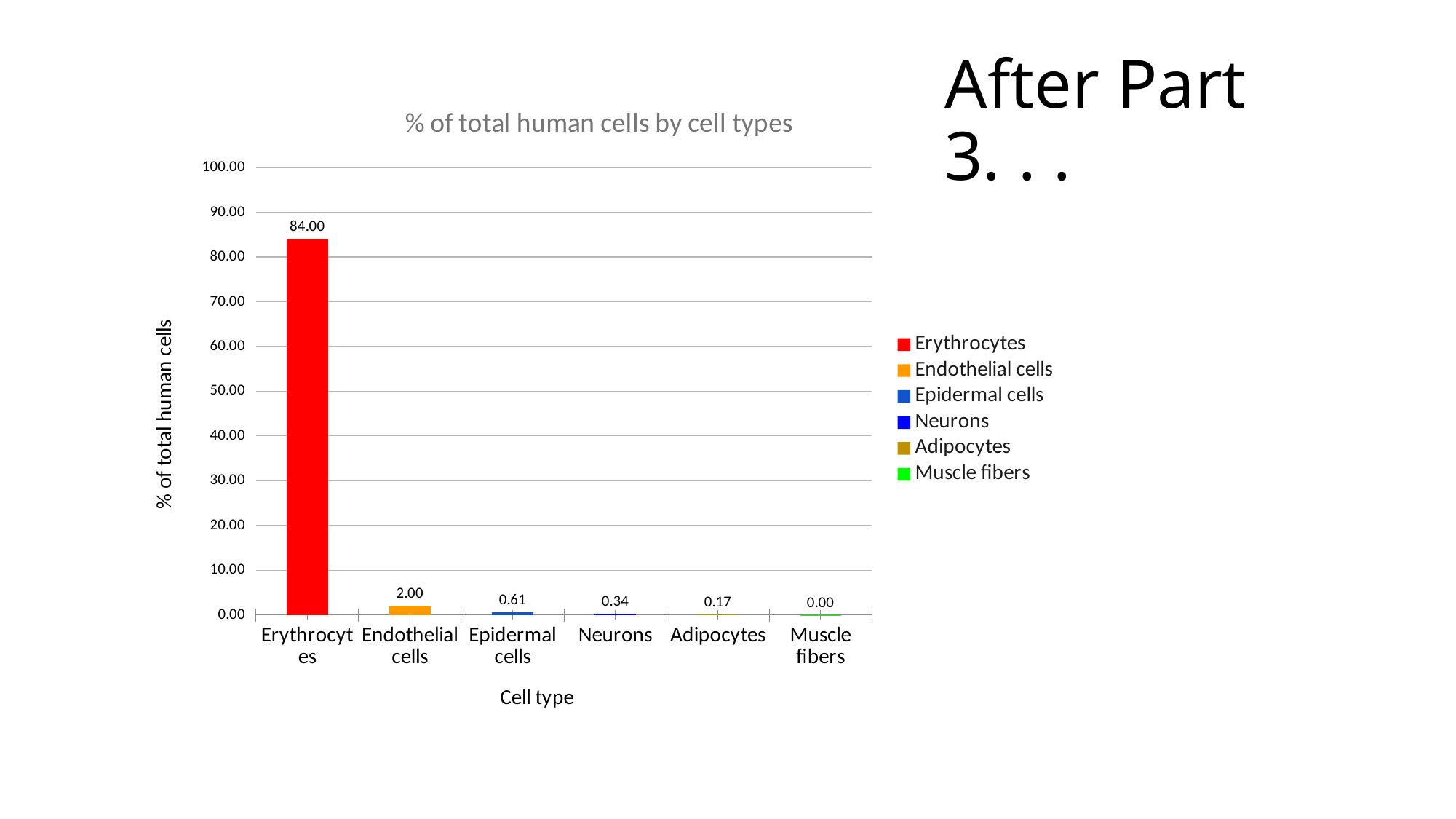
What is the value for Endothelial cells? 2.00 What is the difference between the values for Erythrocytes and Endothelial cells? 82.00 Which is larger, the value for Epidermal cells or the value for Adipocytes? Epidermal cells What is the value for Erythrocytes? 84.00 What is the title of the chart? % of total human cells by cell types What kind of chart is this? bar chart What is the value for Muscle fibers? 0.00 How many cell types are shown on the x axis? 6 What is the value for Neurons? 0.34 Which cell type has the lowest value? Muscle fibers Which cell type has the highest value? Erythrocytes Is the value for Erythrocytes greater or less than 80.00? greater